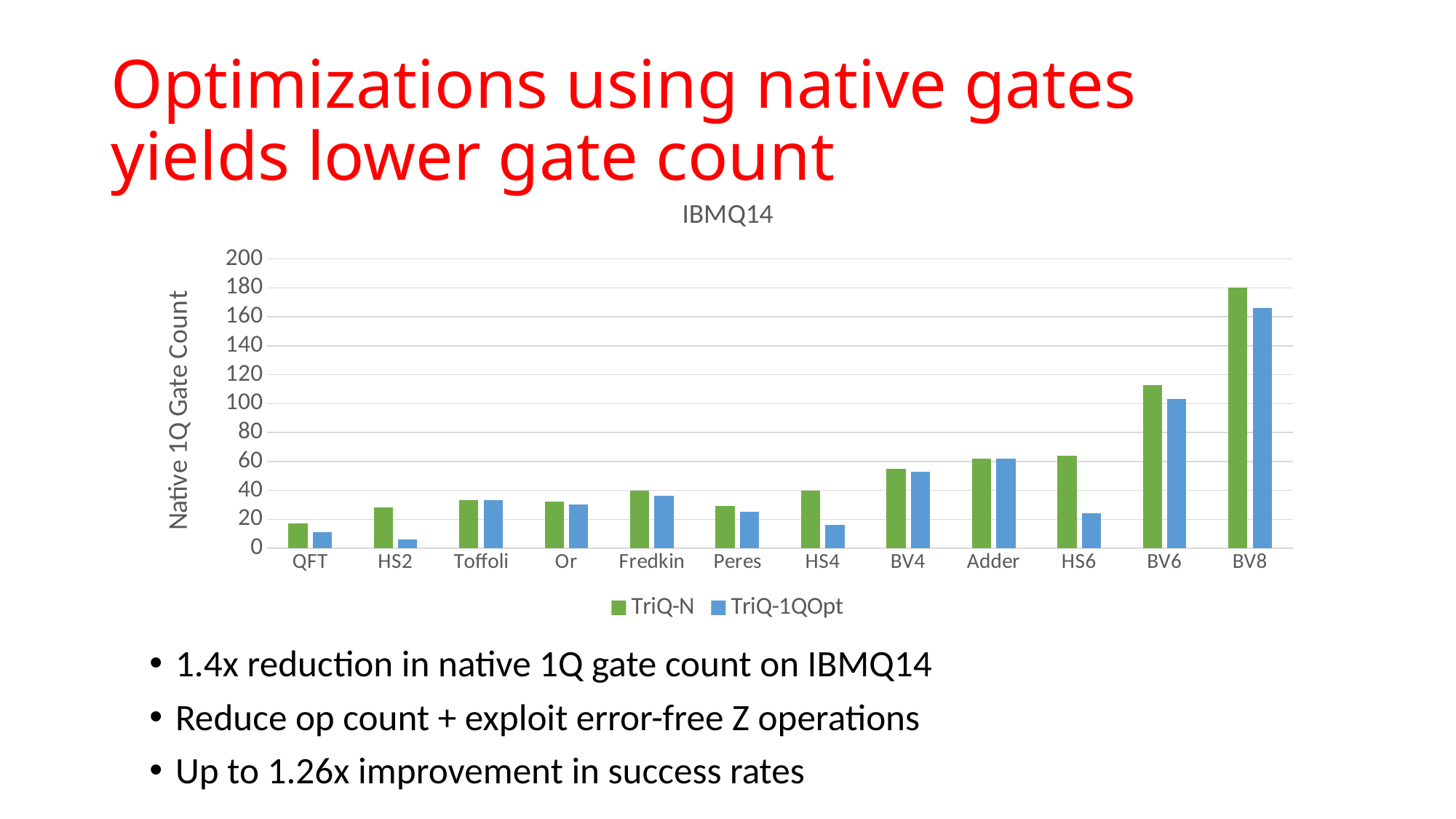
What is the title of the chart? IBMQ14 Is the TriQ-1QOpt value for BV8 greater or less than 140? greater Which category has the lowest TriQ-1QOpt value? HS2 Is the TriQ-1QOpt value for HS2 greater or less than 20? less How many categories are shown on the x axis? 12 Is the TriQ-N value for BV6 greater or less than 100? greater How many series does the legend list? 2 Do the TriQ-N values generally rise or fall from QFT to BV8 along the x axis? rise What kind of chart is shown on the slide? bar chart For HS6, which series has the larger value, TriQ-N or TriQ-1QOpt? TriQ-N Which category has the highest TriQ-N value? BV8 Which category has the lowest TriQ-N value? QFT